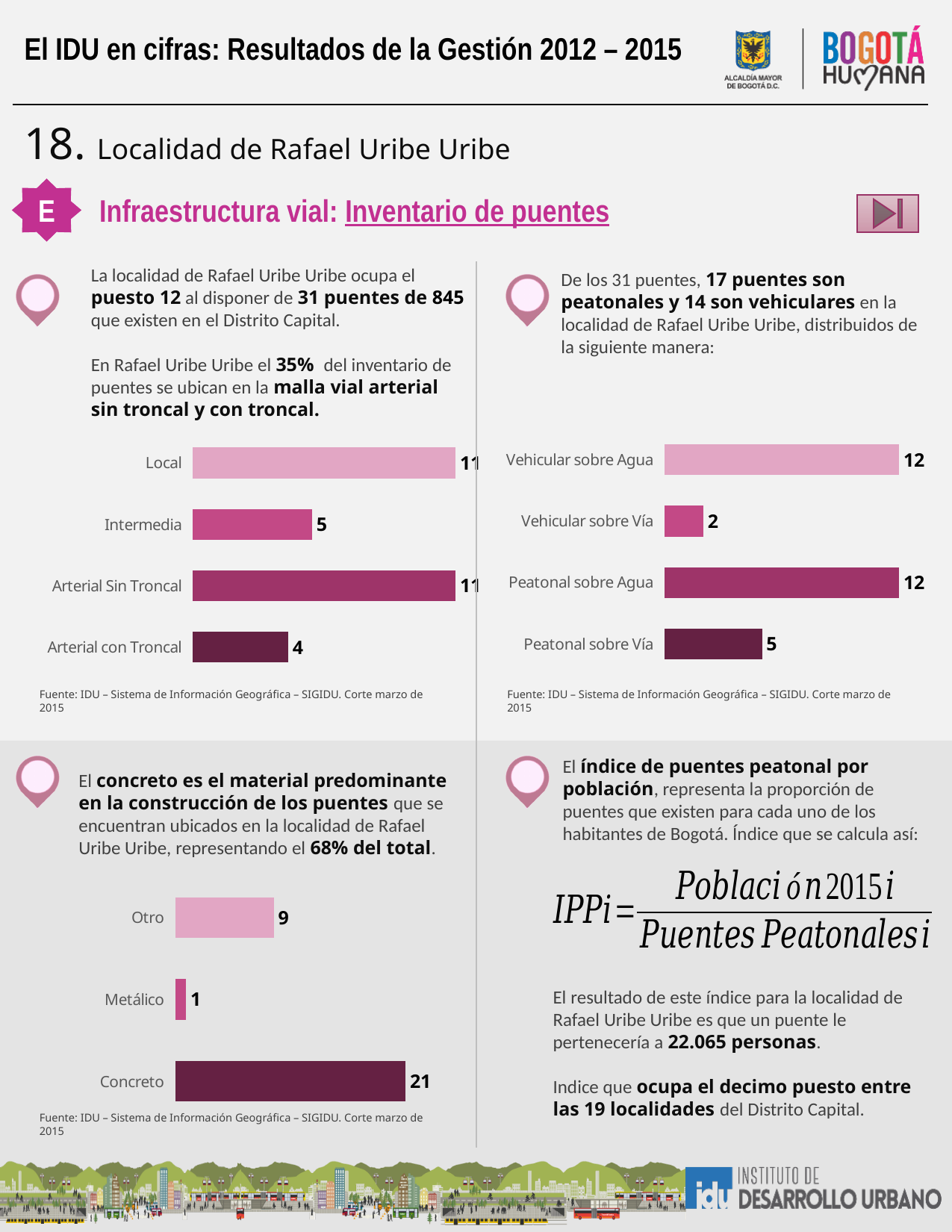
In the bottom-left bar chart, which category has the highest value? Concreto In the top-right bar chart, which category has the lowest value? Vehicular sobre Vía In the top-left bar chart, what is the value for Intermedia? 5 In the top-right bar chart, what is the difference between Vehicular sobre Agua and Vehicular sobre Vía? 10 What type of chart is the bottom-left chart? Bar chart In the top-right bar chart, which is larger: Peatonal sobre Agua or Peatonal sobre Vía? Peatonal sobre Agua In the top-left bar chart, what is the value for Arterial con Troncal? 4 In the bottom-left bar chart, what is the value for Concreto? 21 In the top-left bar chart, which category has the lowest value? Arterial con Troncal How many categories are shown in the top-left bar chart? 4 In the bottom-left bar chart, what is the difference between Concreto and Otro? 12 In the top-right bar chart, what is the value for Peatonal sobre Vía? 5